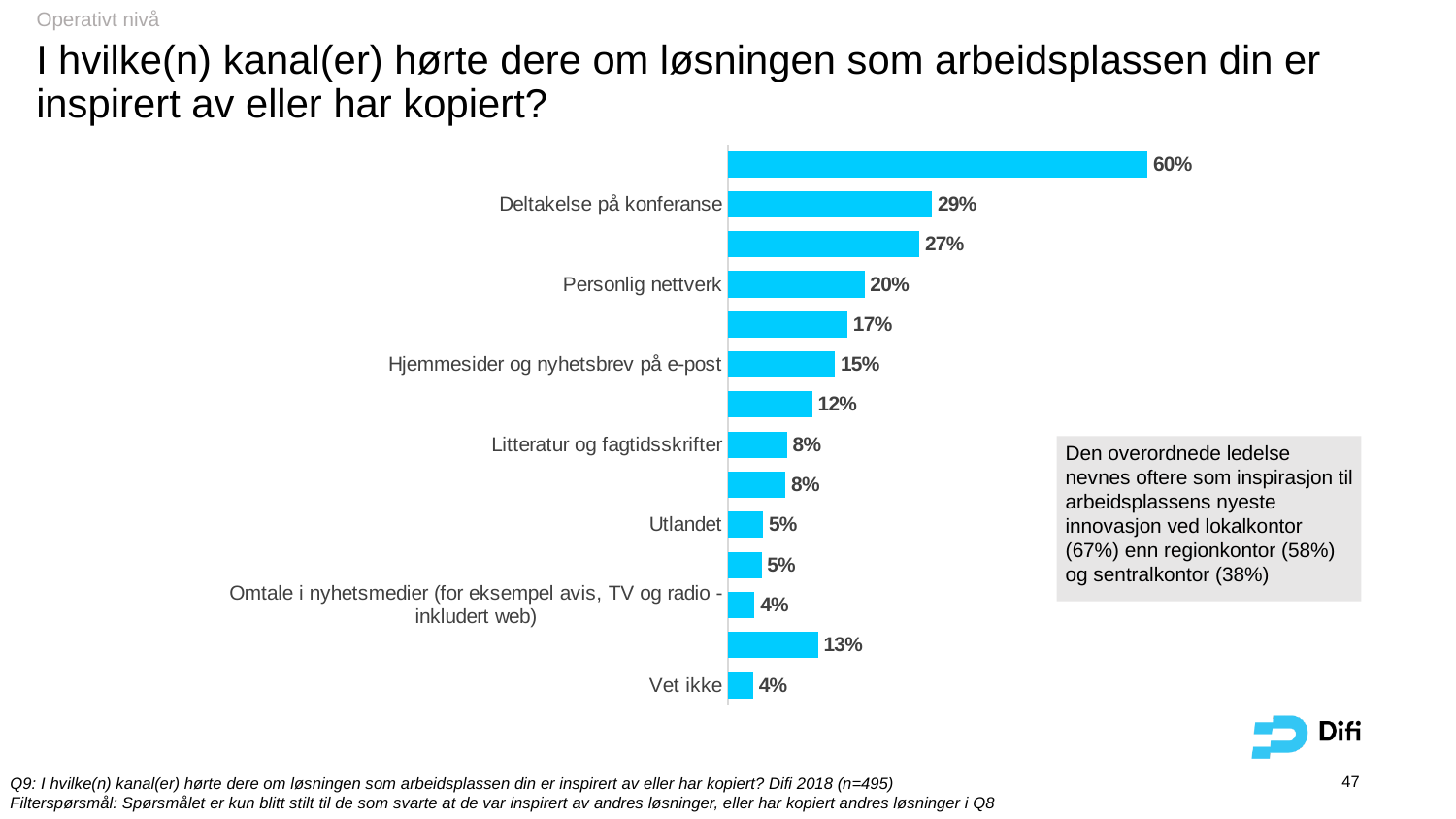
What percentage is shown for "Hjemmesider og nyhetsbrev på e-post"? 15% What percentage is shown for "Deltakelse på konferanse"? 29% What is the value for "Vet ikke"? 4% Which has a larger value, "Hjemmesider og nyhetsbrev på e-post" or "Litteratur og fagtidsskrifter"? Hjemmesider og nyhetsbrev på e-post What is the value for "Personlig nettverk"? 20% How many bars are plotted on the chart? 14 What kind of chart is shown on the slide? Bar chart What colour are the bars in the chart? Light blue What is the difference between the values for "Deltakelse på konferanse" and "Personlig nettverk"? 9% What is the highest value shown on the chart? 60% What percentage is shown for "Utlandet"? 5% What is the value for "Litteratur og fagtidsskrifter"? 8%